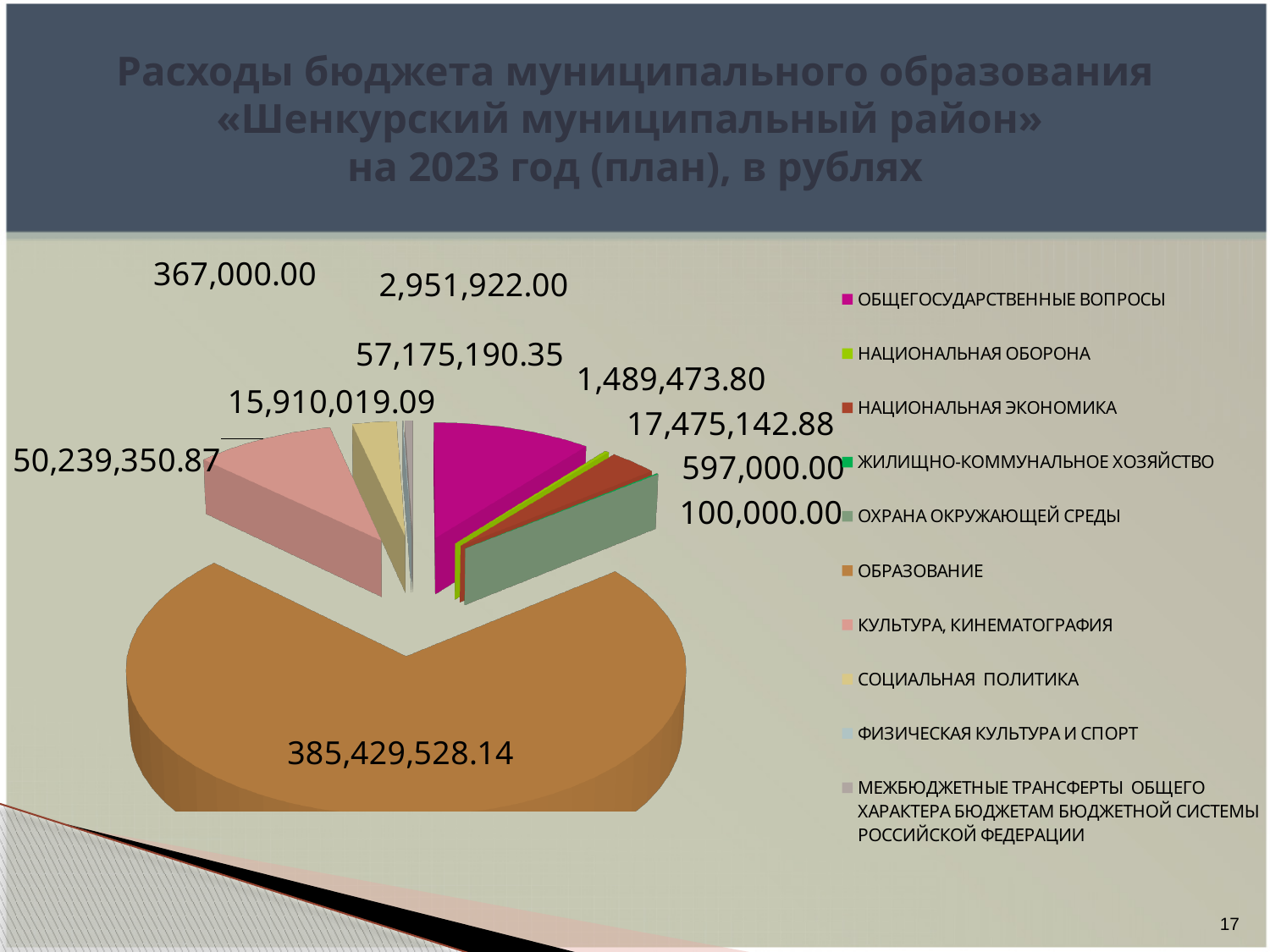
Which is larger, the value for ОБЩЕГОСУДАРСТВЕННЫЕ ВОПРОСЫ or the value for КУЛЬТУРА, КИНЕМАТОГРАФИЯ? ОБЩЕГОСУДАРСТВЕННЫЕ ВОПРОСЫ What is the value for ОБЩЕГОСУДАРСТВЕННЫЕ ВОПРОСЫ? 57,175,190.35 What is the value for КУЛЬТУРА, КИНЕМАТОГРАФИЯ? 50,239,350.87 What is the smallest value labelled on the chart? 100,000.00 What is the difference between the values for ОБРАЗОВАНИЕ and КУЛЬТУРА, КИНЕМАТОГРАФИЯ? 335,190,177.27 What is the value for ОБРАЗОВАНИЕ? 385,429,528.14 Which category has the largest slice of the pie? ОБРАЗОВАНИЕ What colour is the ОБРАЗОВАНИЕ slice in the pie chart? Orange-brown What type of chart is shown on the slide? Pie chart What is the title of the slide containing the chart? Расходы бюджета муниципального образования «Шенкурский муниципальный район» на 2023 год (план), в рублях What is the value for СОЦИАЛЬНАЯ ПОЛИТИКА? 15,910,019.09 How many categories does the legend list? 10